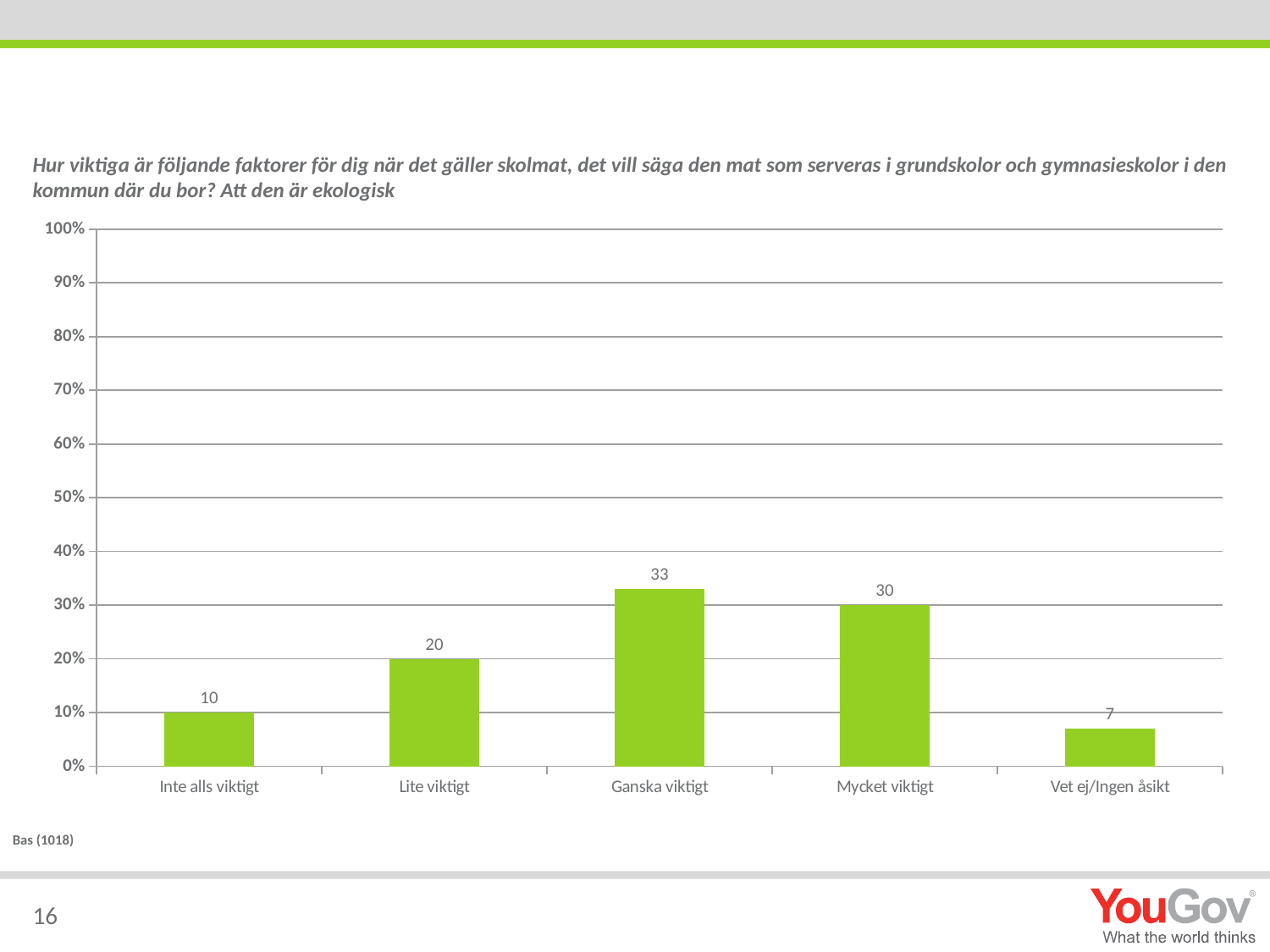
Which category has the lowest value? Vet ej/Ingen åsikt What is the value for "Vet ej/Ingen åsikt"? 7 Which category has the highest value? Ganska viktigt Which is larger, the value for "Lite viktigt" or the value for "Mycket viktigt"? Mycket viktigt Is the value for "Mycket viktigt" greater or less than 20%? greater What is the difference between the values for "Lite viktigt" and "Inte alls viktigt"? 10 What kind of chart is shown on the slide? Bar chart What is the difference between the values for "Ganska viktigt" and "Mycket viktigt"? 3 What is the value for "Ganska viktigt"? 33 How many categories are shown on the x axis? 5 What is the base (Bas) shown below the chart? 1018 What is the value for "Inte alls viktigt"? 10